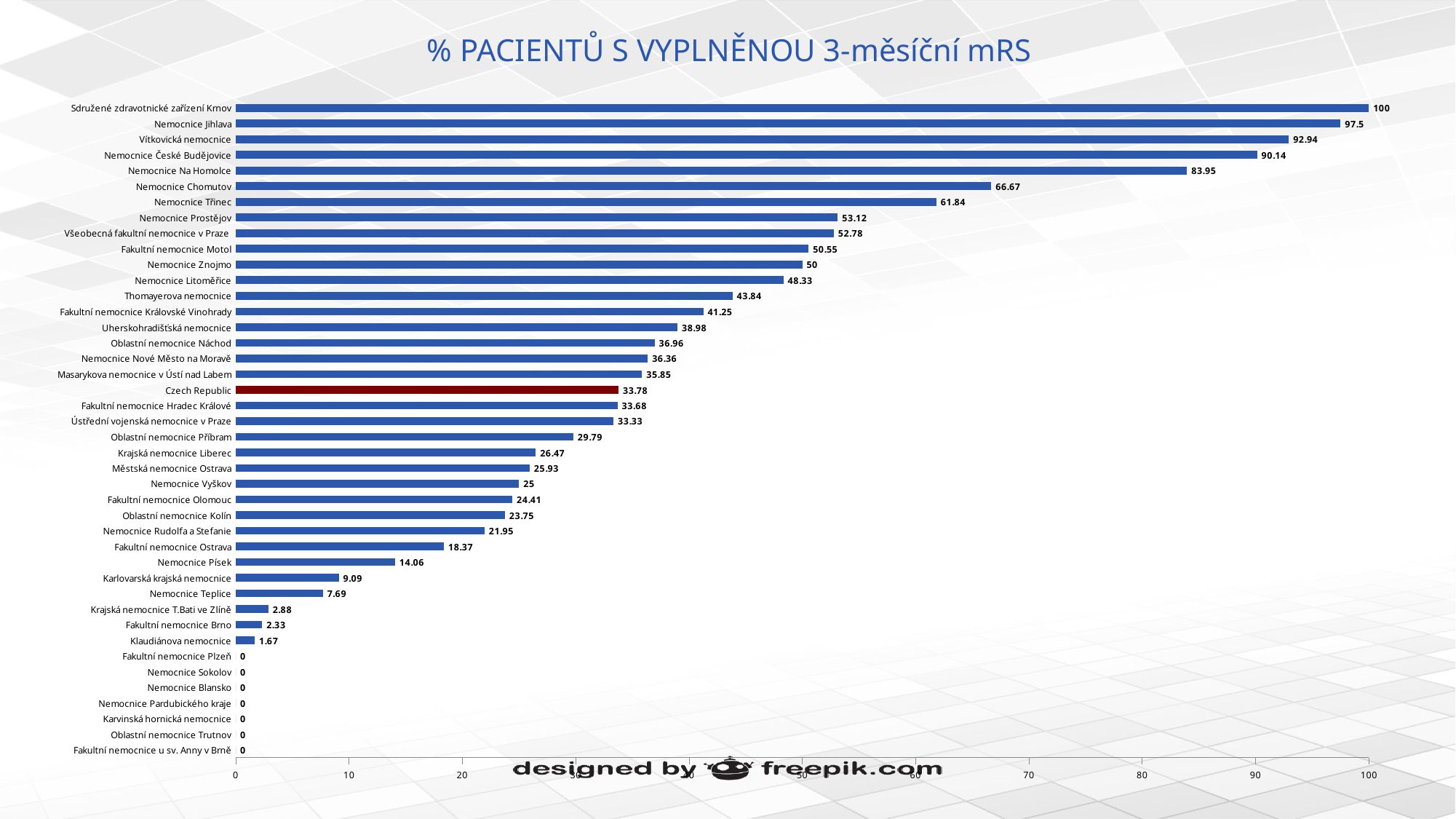
What is the difference between the values for Czech Republic and Fakultní nemocnice Hradec Králové? 0.1 What is the title of the chart? % PACIENTŮ S VYPLNĚNOU 3-měsíční mRS How many categories are shown on the chart? 42 How many categories have a value of 0? 7 What is the value for Nemocnice Na Homolce? 83.95 What is the value for Czech Republic? 33.78 Which bar is coloured dark red instead of blue? Czech Republic What kind of chart is shown? bar chart What is the difference between the values for Nemocnice Jihlava and Vítkovická nemocnice? 4.56 What is the value for Fakultní nemocnice Motol? 50.55 Which is larger, the value for Nemocnice Chomutov or Nemocnice Třinec? Nemocnice Chomutov Which category has the highest value? Sdružené zdravotnické zařízení Krnov